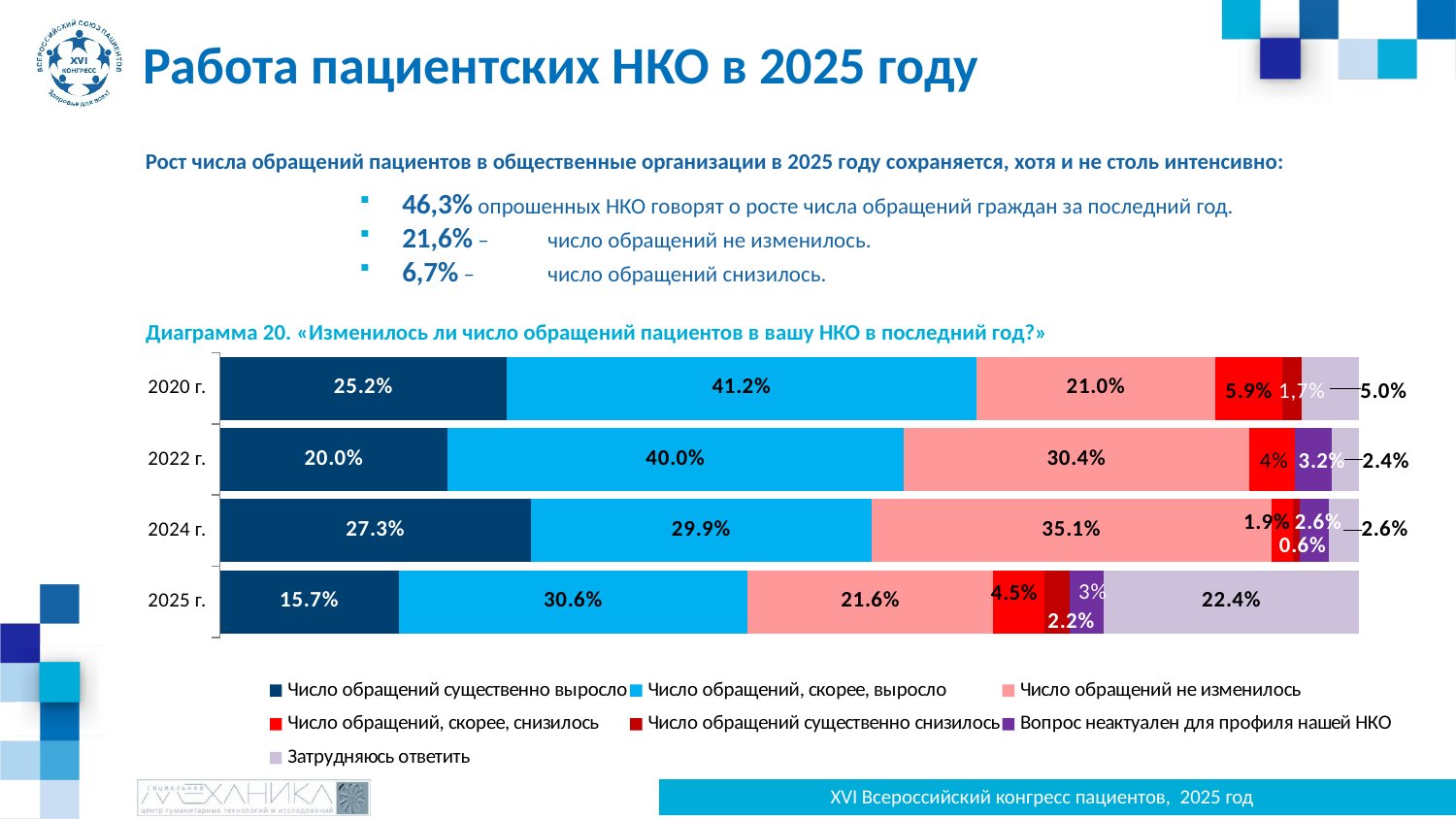
How many years (categories) are shown in the chart? 4 What is the title of the chart? Диаграмма 20. «Изменилось ли число обращений пациентов в вашу НКО в последний год?» In which year is the value for "Число обращений, скорее, выросло" the highest? 2020 г. What kind of chart is shown on the slide? Stacked bar chart What is the value for "Затрудняюсь ответить" in 2025 г.? 22.4% Which year has the larger value for "Число обращений не изменилось": 2022 г. or 2024 г.? 2024 г. In which year is the value for "Число обращений существенно выросло" the lowest? 2025 г. What is the value for "Число обращений не изменилось" in 2024 г.? 35.1% What is the value for "Число обращений существенно выросло" in 2020 г.? 25.2% What is the value for "Число обращений не изменилось" in 2022 г.? 30.4% What is the difference between the "Число обращений, скорее, выросло" values for 2022 г. and 2025 г.? 9.4 percentage points How many series does the chart legend list? 7